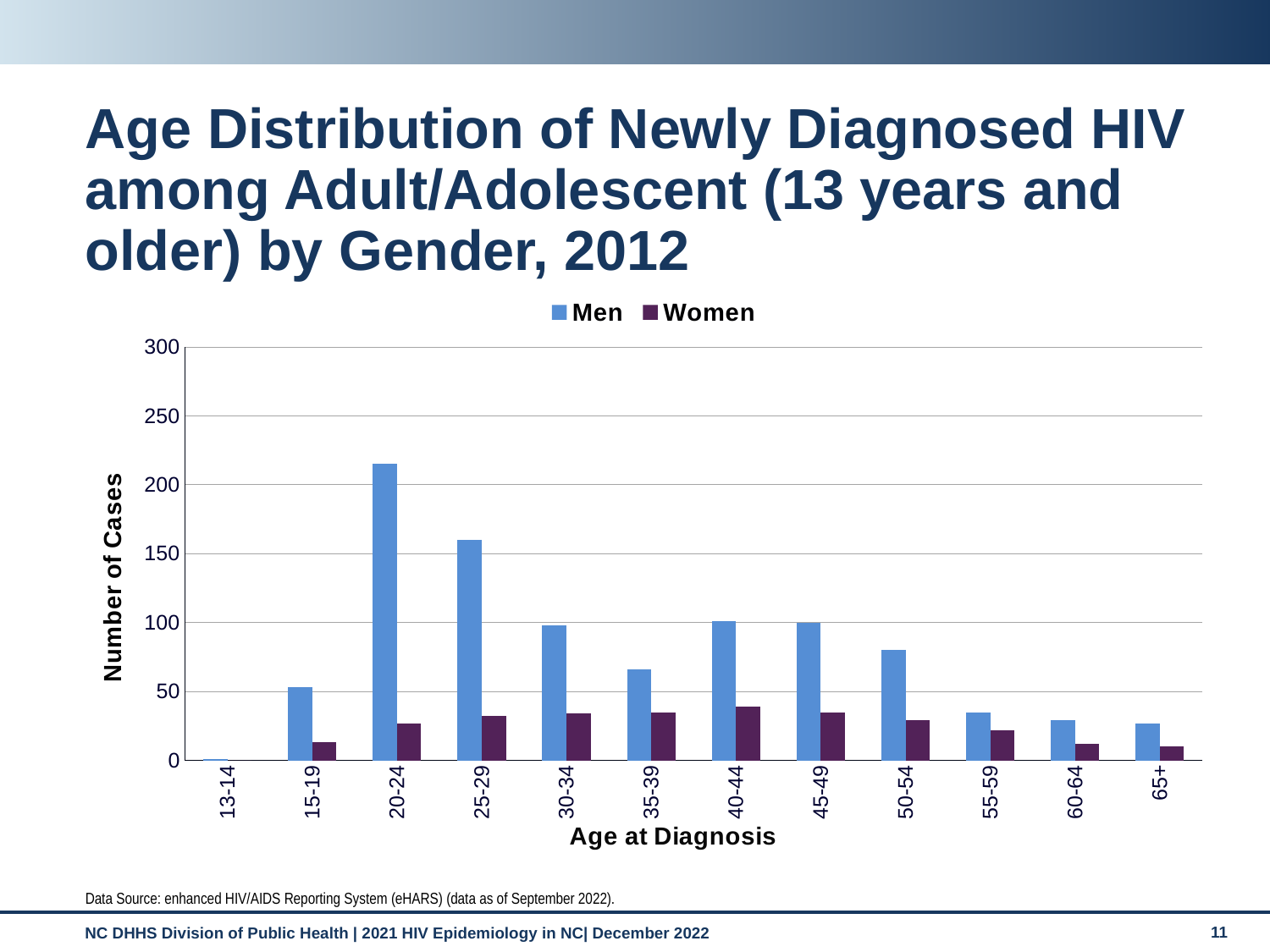
For Men, which age group has more cases, 25-29 or 30-34? 25-29 Is the value for Men in the 20-24 age group greater or less than 200? greater Do the values for Women rise or fall from the 40-44 age group to the 65+ age group? fall How many age groups are shown on the x axis? 12 In the 20-24 age group, which series has more cases, Men or Women? Men Which age group has the lowest number of cases for Men? 13-14 Is the value for Men in the 50-54 age group greater or less than 100? less Which age group has the highest number of cases for Men? 20-24 What kind of chart is shown on the slide? bar chart How many series does the legend list? 2 Is the value for Men in the 25-29 age group greater or less than 150? greater